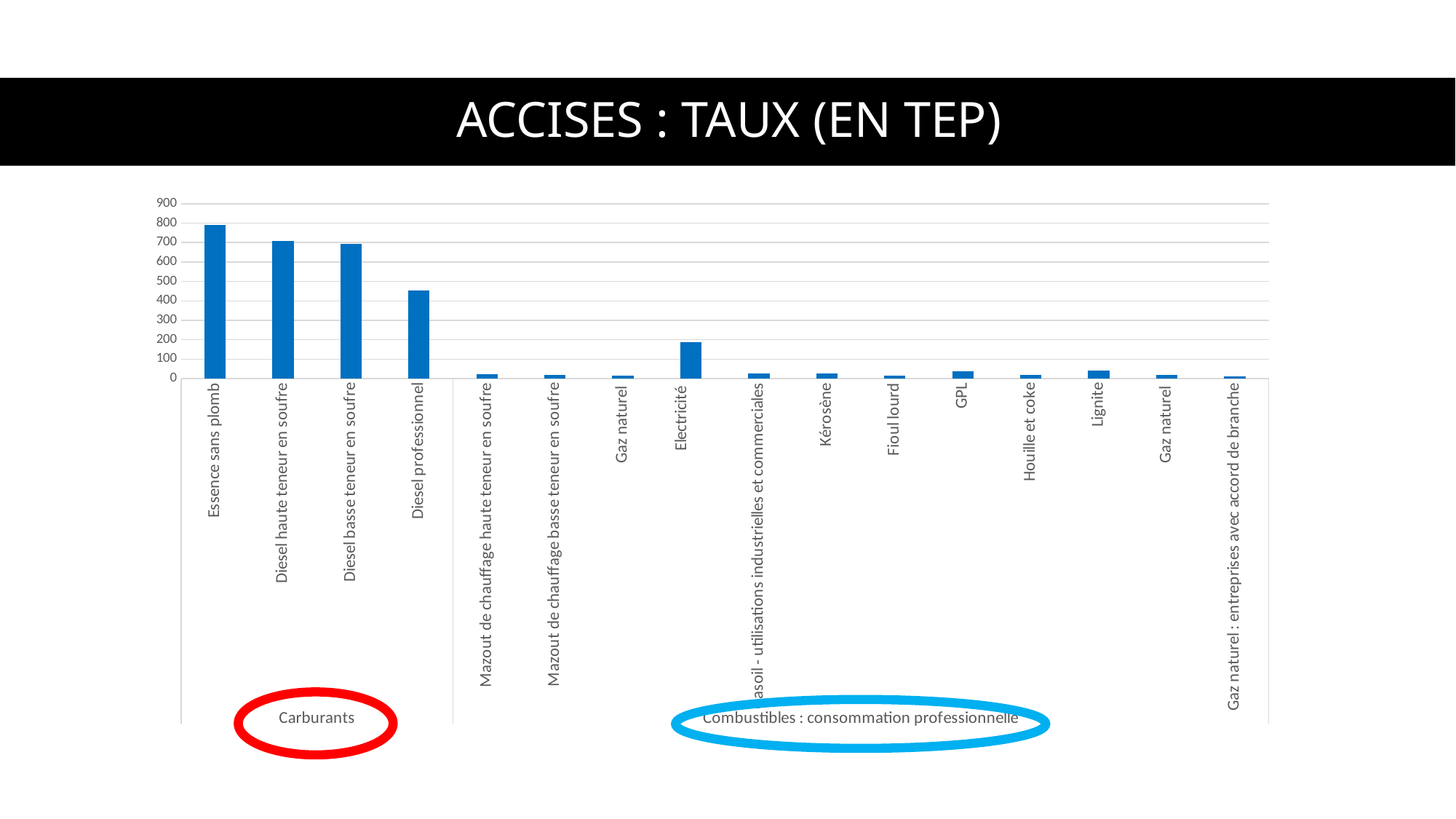
Is the value for Electricité greater or less than 100? greater Is the value for Diesel professionnel greater or less than 500? less Which is larger, the value for Essence sans plomb or the value for Diesel professionnel? Essence sans plomb Is the value for Diesel professionnel greater or less than 400? greater How many categories are plotted in total on the chart? 16 What is the title of the slide? ACCISES : TAUX (EN TEP) What kind of chart is shown on the slide? bar chart How many categories are in the Carburants group? 4 Which is larger, the value for Electricité or the value for GPL? Electricité Which category has the highest value? Essence sans plomb